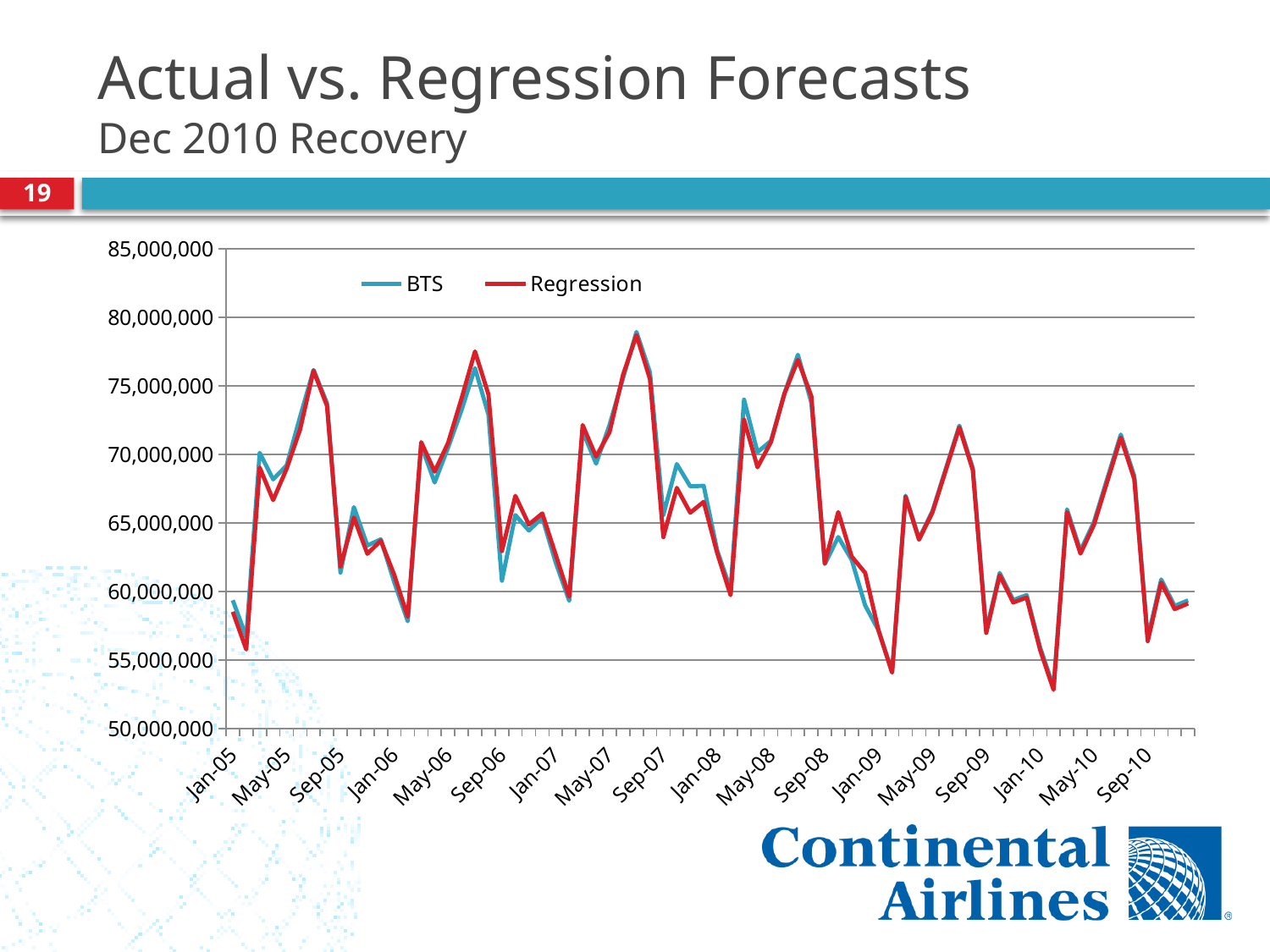
How many series does the chart's legend list? 2 Is the BTS value at Jan-10 greater or less than 55,000,000? greater Which colour is used for the Regression series? Red Is the Regression value at Sep-10 greater or less than 65,000,000? less Which is larger, the BTS value at Jan-09 or at Jan-10? Jan-09 What are the names of the two series in the legend? BTS and Regression What kind of chart is shown on the slide? Line chart Is the BTS value at Jan-09 greater or less than 60,000,000? less In which year does the BTS series reach its highest peak? 2007